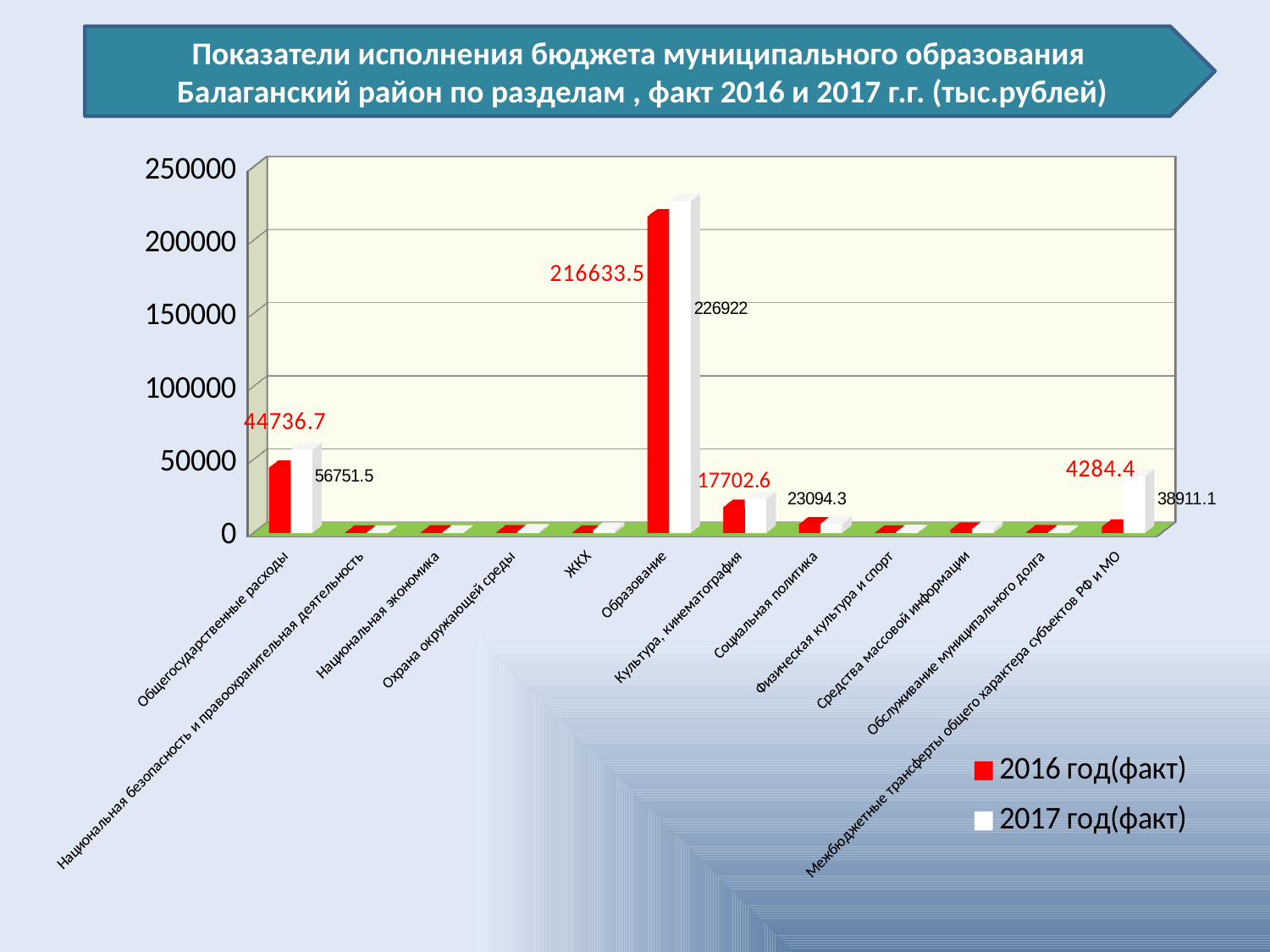
What is the 2016 год(факт) value for Образование? 216633.5 Which category has the highest value in the 2017 год(факт) series? Образование What is the difference between the 2017 and 2016 values for Образование? 10288.5 Which is larger for Общегосударственные расходы: the 2016 год(факт) value or the 2017 год(факт) value? 2017 год(факт) How many series does the legend list? 2 What is the 2017 год(факт) value for Культура, кинематография? 23094.3 What is the 2017 год(факт) value for Общегосударственные расходы? 56751.5 How many categories are shown on the x axis? 12 What is the 2016 год(факт) value for Межбюджетные трансферты общего характера субъектов РФ и МО? 4284.4 Is the 2016 год(факт) value for Образование greater or less than 200000? greater What is the difference between the 2017 and 2016 values for Межбюджетные трансферты общего характера субъектов РФ и МО? 34626.7 What type of chart is shown on the slide? bar chart